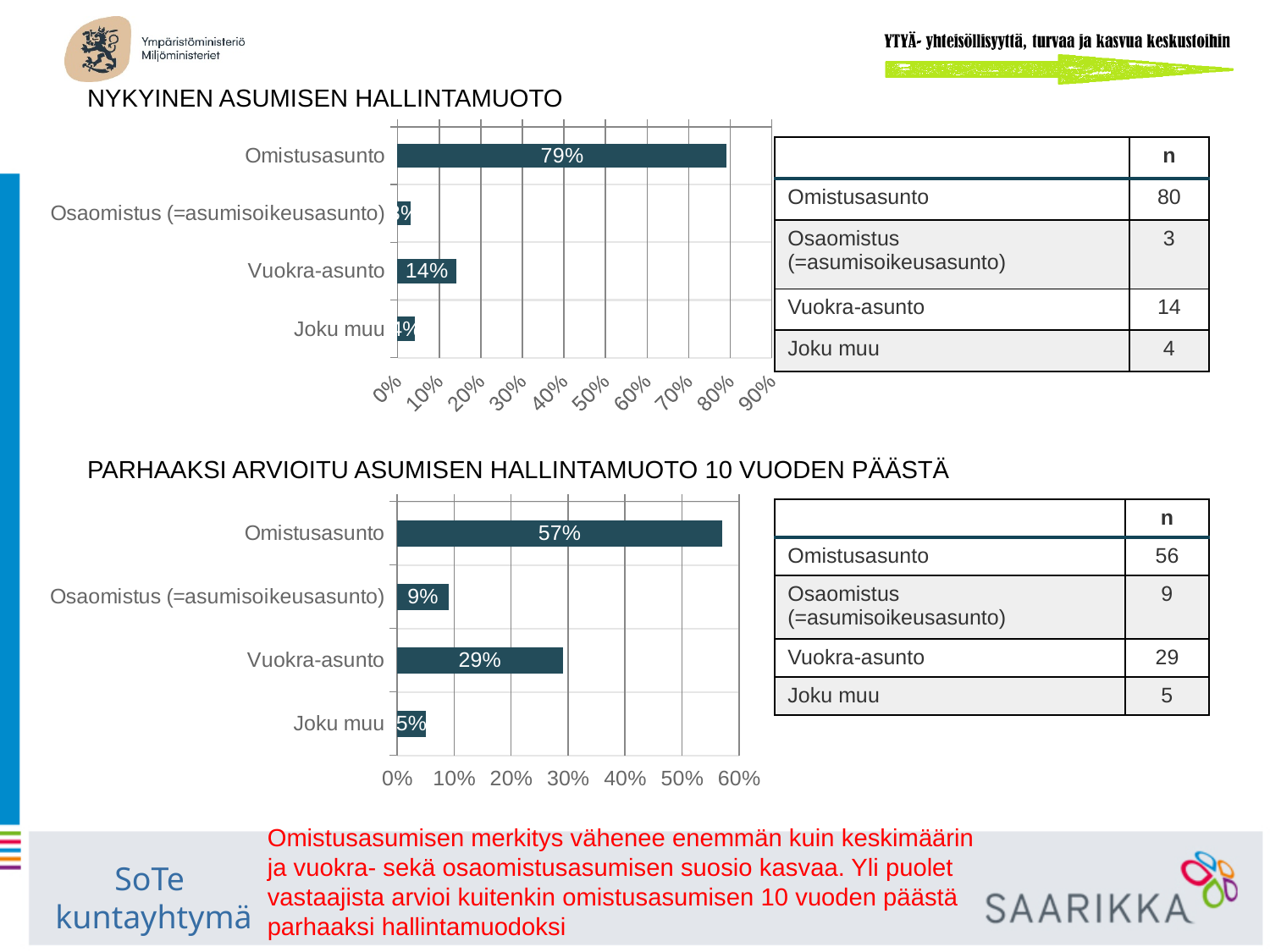
In the chart titled NYKYINEN ASUMISEN HALLINTAMUOTO, what is the value for Omistusasunto? 79% In the chart titled NYKYINEN ASUMISEN HALLINTAMUOTO, what is the value for Vuokra-asunto? 14% In the chart titled PARHAAKSI ARVIOITU ASUMISEN HALLINTAMUOTO 10 VUODEN PÄÄSTÄ, what is the value for Vuokra-asunto? 29% In the chart titled PARHAAKSI ARVIOITU ASUMISEN HALLINTAMUOTO 10 VUODEN PÄÄSTÄ, what is the value for Osaomistus (=asumisoikeusasunto)? 9% In the chart titled NYKYINEN ASUMISEN HALLINTAMUOTO, which category has the highest value? Omistusasunto In the chart titled PARHAAKSI ARVIOITU ASUMISEN HALLINTAMUOTO 10 VUODEN PÄÄSTÄ, which is larger, the value for Vuokra-asunto or the value for Osaomistus (=asumisoikeusasunto)? Vuokra-asunto In the chart titled PARHAAKSI ARVIOITU ASUMISEN HALLINTAMUOTO 10 VUODEN PÄÄSTÄ, which category has the lowest value? Joku muu In the chart titled PARHAAKSI ARVIOITU ASUMISEN HALLINTAMUOTO 10 VUODEN PÄÄSTÄ, what is the difference between the values for Omistusasunto and Vuokra-asunto? 28% In the chart titled NYKYINEN ASUMISEN HALLINTAMUOTO, what is the difference between the values for Omistusasunto and Vuokra-asunto? 65% In the chart titled NYKYINEN ASUMISEN HALLINTAMUOTO, is the value for Joku muu greater or less than 10%? less In the chart titled PARHAAKSI ARVIOITU ASUMISEN HALLINTAMUOTO 10 VUODEN PÄÄSTÄ, what is the value for Omistusasunto? 57% How many categories does the chart titled PARHAAKSI ARVIOITU ASUMISEN HALLINTAMUOTO 10 VUODEN PÄÄSTÄ show? 4